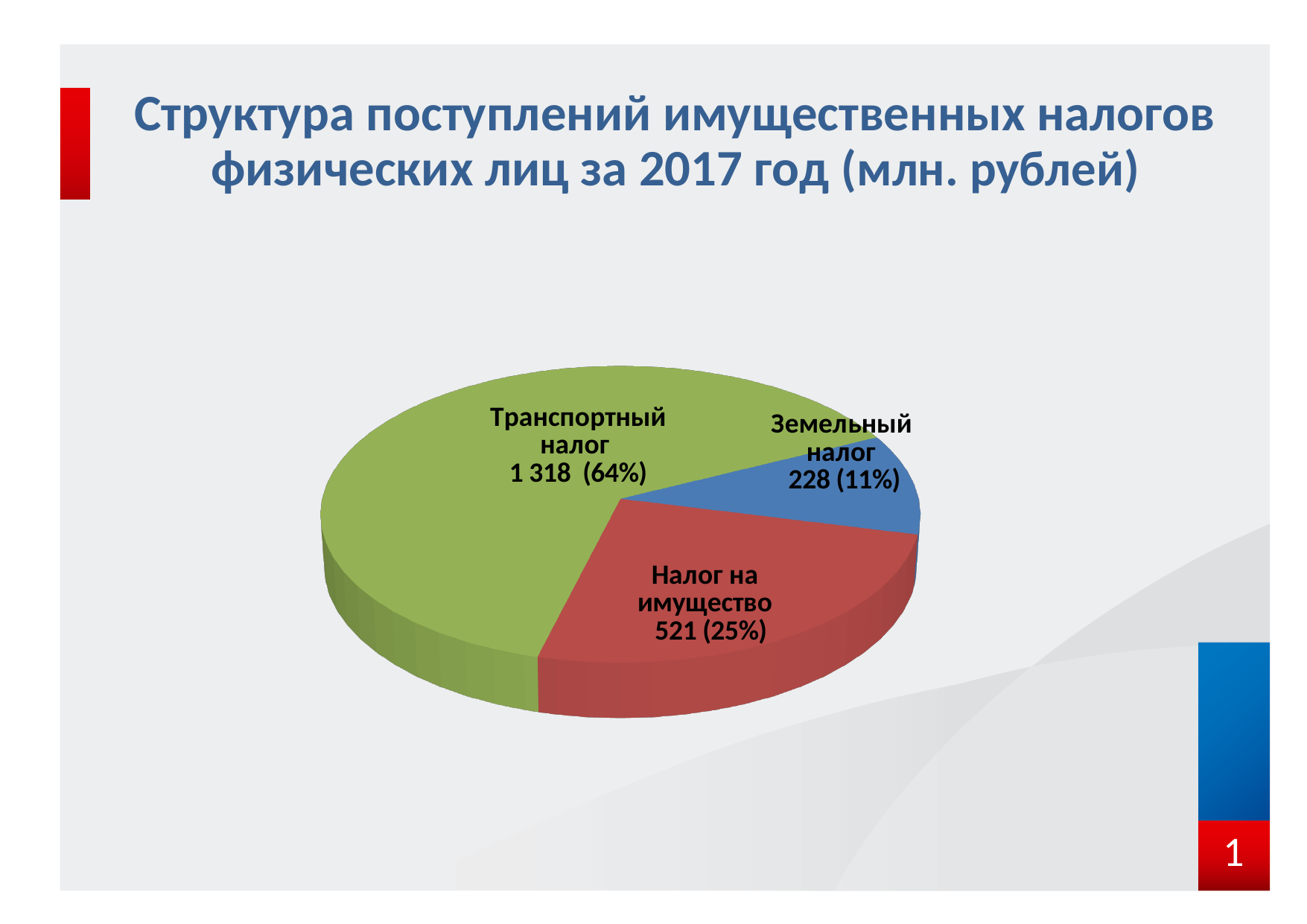
How many slices does the pie chart have? 3 What is the value for Транспортный налог? 1 318 What is the value for Налог на имущество? 521 What share of the pie does Налог на имущество represent? 25% What is the value for Земельный налог? 228 Which category has the smallest share of the pie? Земельный налог Which is larger, the value for Налог на имущество or the value for Земельный налог? Налог на имущество What is the difference between the values for Транспортный налог and Налог на имущество? 797 What is the title of the chart on the slide? Структура поступлений имущественных налогов физических лиц за 2017 год (млн. рублей) Which category has the largest share of the pie? Транспортный налог What share of the pie does Земельный налог represent? 11% What type of chart is shown on the slide? Pie chart